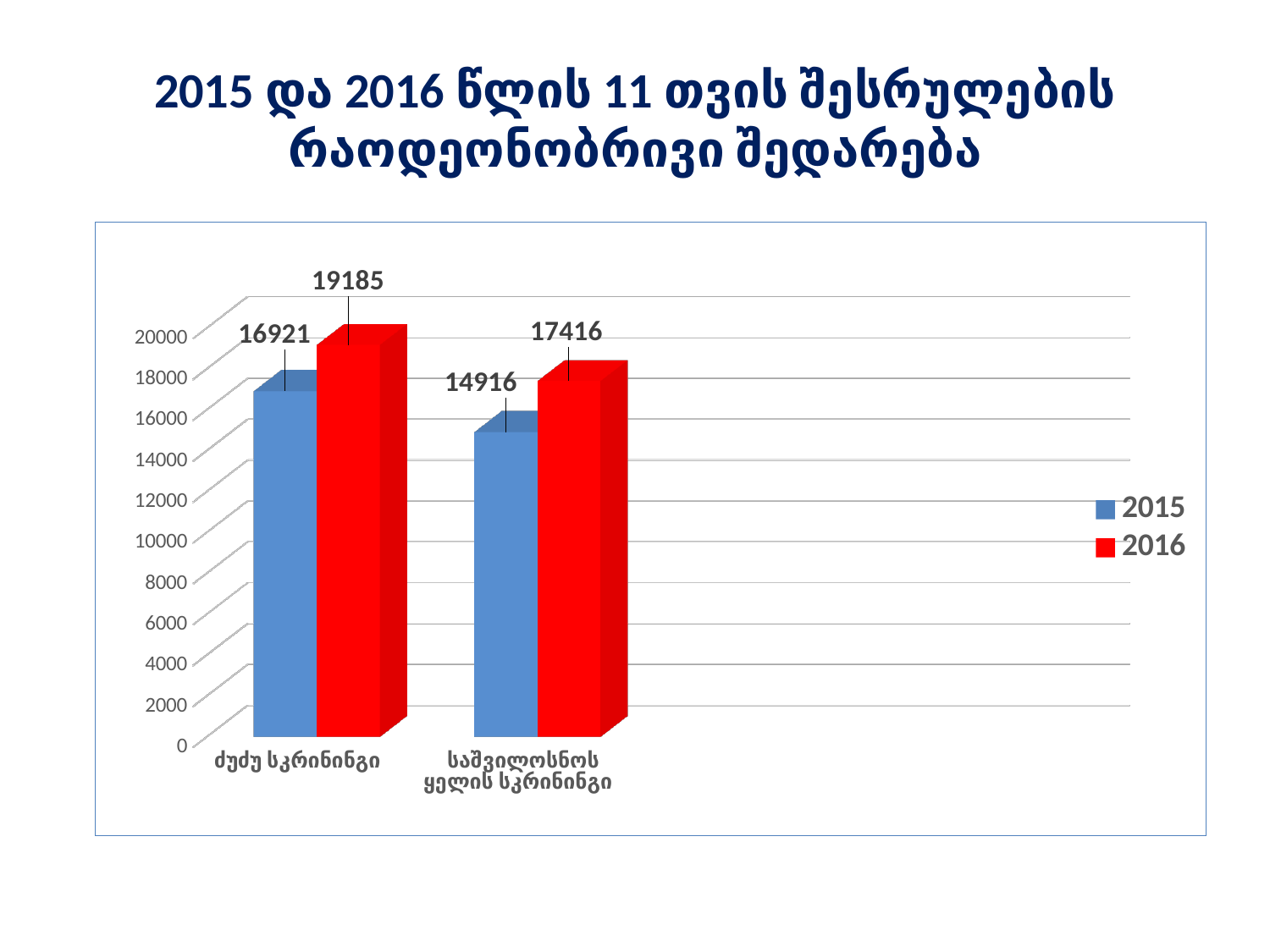
What is the value for საშვილოსნოს ყელის სკრინინგი in 2015? 14916 How many series does the legend list? 2 Which category has the lowest value in the 2015 series? საშვილოსნოს ყელის სკრინინგი Which category has the highest value in the 2016 series? ძუძუ სკრინინგი What is the difference between the 2016 and 2015 values for ძუძუ სკრინინგი? 2264 Which is larger: the 2015 value for ძუძუ სკრინინგი or the 2016 value for საშვილოსნოს ყელის სკრინინგი? 2016 value for საშვილოსნოს ყელის სკრინინგი What is the value for ძუძუ სკრინინგი in 2016? 19185 What kind of chart is shown on the slide? Bar chart What is the difference between the 2016 and 2015 values for საშვილოსნოს ყელის სკრინინგი? 2500 What is the value for საშვილოსნოს ყელის სკრინინგი in 2016? 17416 How many categories are shown on the x axis? 2 What is the value for ძუძუ სკრინინგი in 2015? 16921